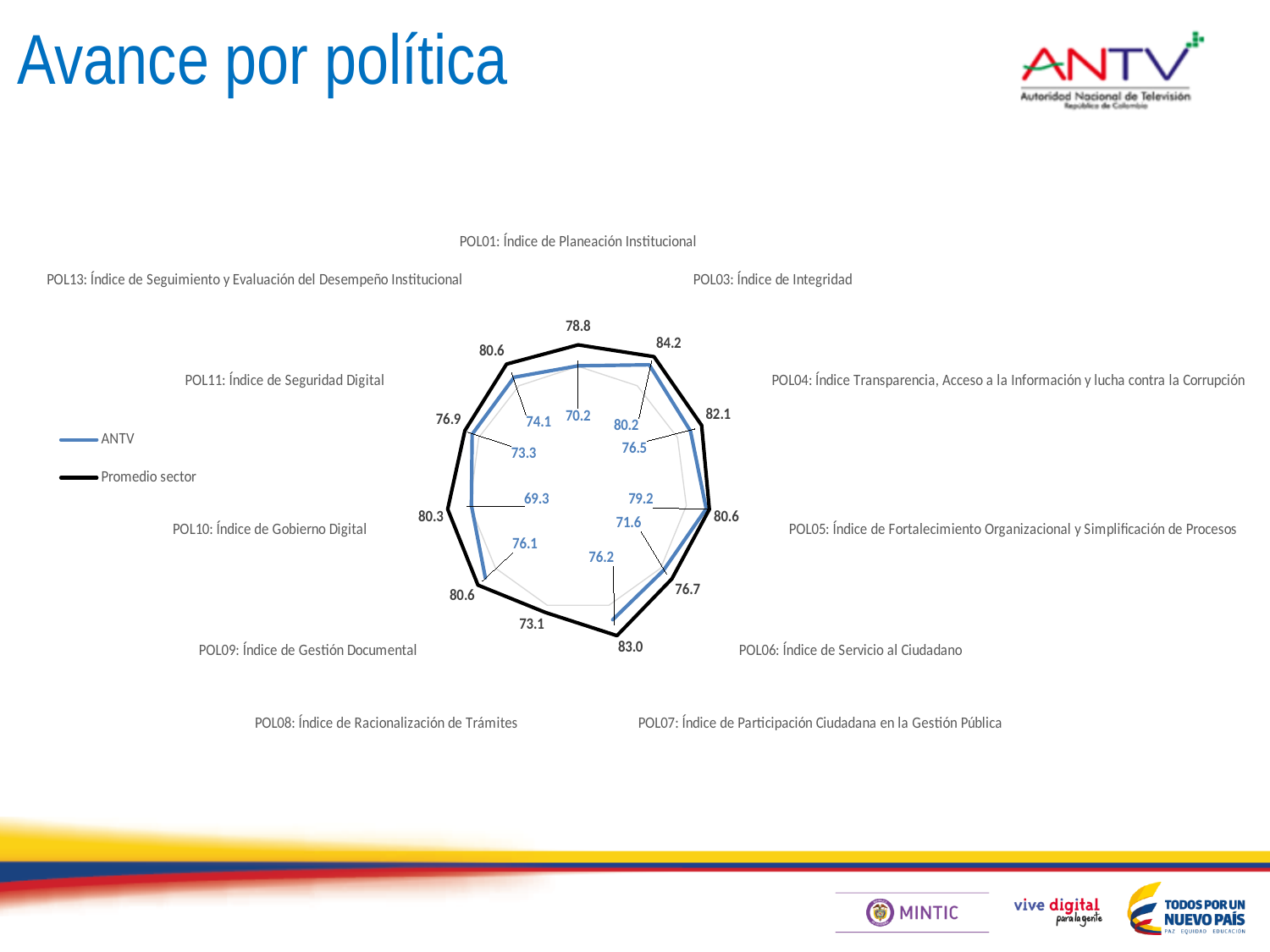
What is the ANTV value for POL01: Índice de Planeación Institucional? 70.2 What is the Promedio sector value for POL03: Índice de Integridad? 84.2 What is the Promedio sector value for POL01: Índice de Planeación Institucional? 78.8 For POL03: Índice de Integridad, which is larger, the ANTV value or the Promedio sector value? Promedio sector How many series does the legend list? 2 What is the difference between the Promedio sector and ANTV values for POL01: Índice de Planeación Institucional? 8.6 Which category has the highest Promedio sector value? POL03: Índice de Integridad How many policy categories (axes) does the radar chart have? 11 What are the two series named in the legend? ANTV and Promedio sector What is the ANTV value for POL10: Índice de Gobierno Digital? 69.3 Which category has the lowest Promedio sector value? POL08: Índice de Racionalización de Trámites What kind of chart is shown on the slide? Radar chart